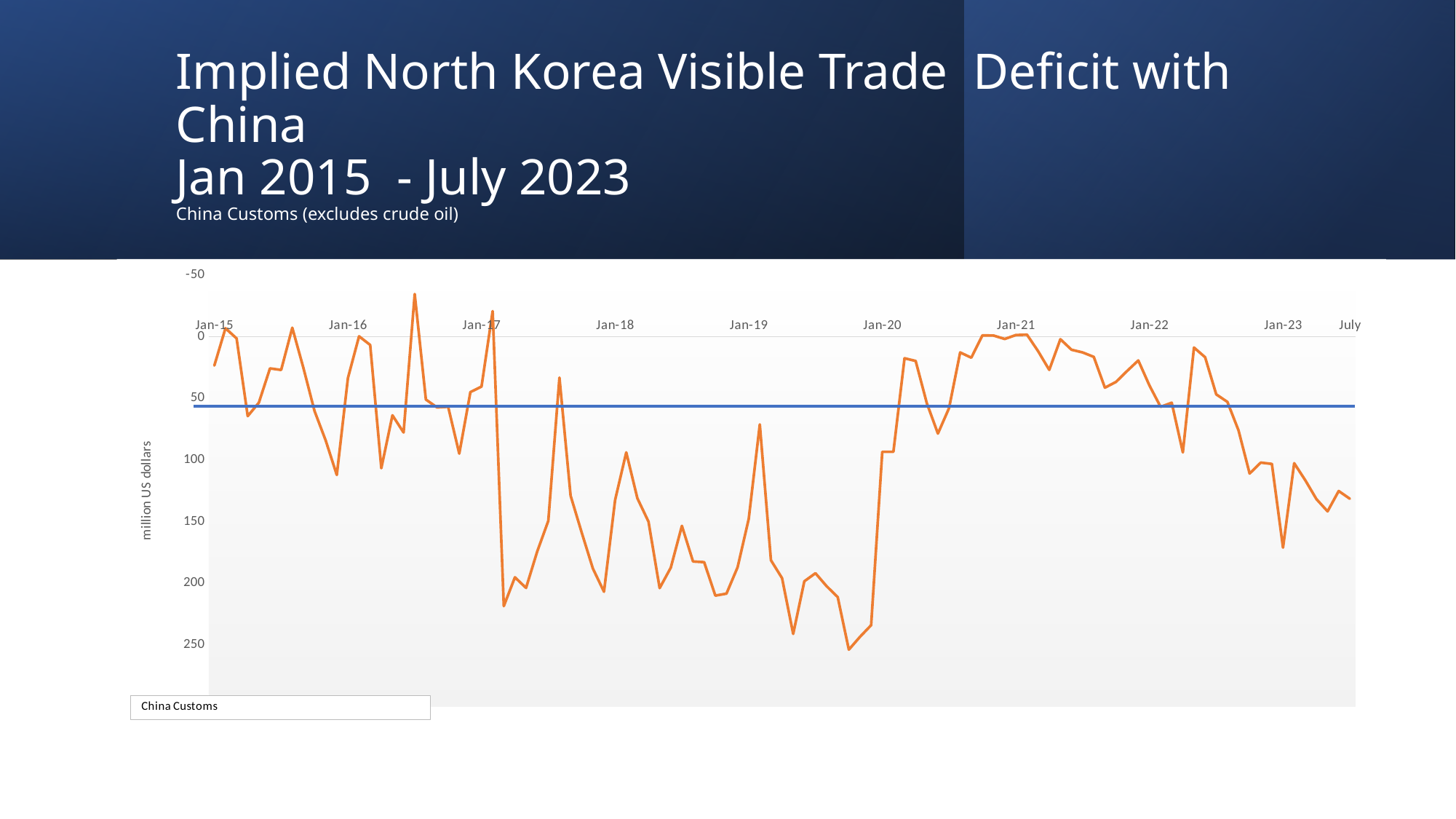
What kind of chart is shown on the slide? line chart What is the lowest tick value shown at the top of the vertical axis? -50 Is the value of the orange line at July 2023 (the last point) greater or less than 100? greater Is the lowest point of the orange line (in late 2019) greater or less than 200? greater How many 'Jan-' year labels appear on the x axis of the chart? 9 Is the value of the orange line at July 2023 (the last point) greater or less than 150? less What is the title of the chart on the slide? Implied North Korea Visible Trade Deficit with China Jan 2015 - July 2023 Between Jan-22 and July 2023, does the orange line's value rise or fall overall? rise What is the label on the vertical axis of the chart? million US dollars